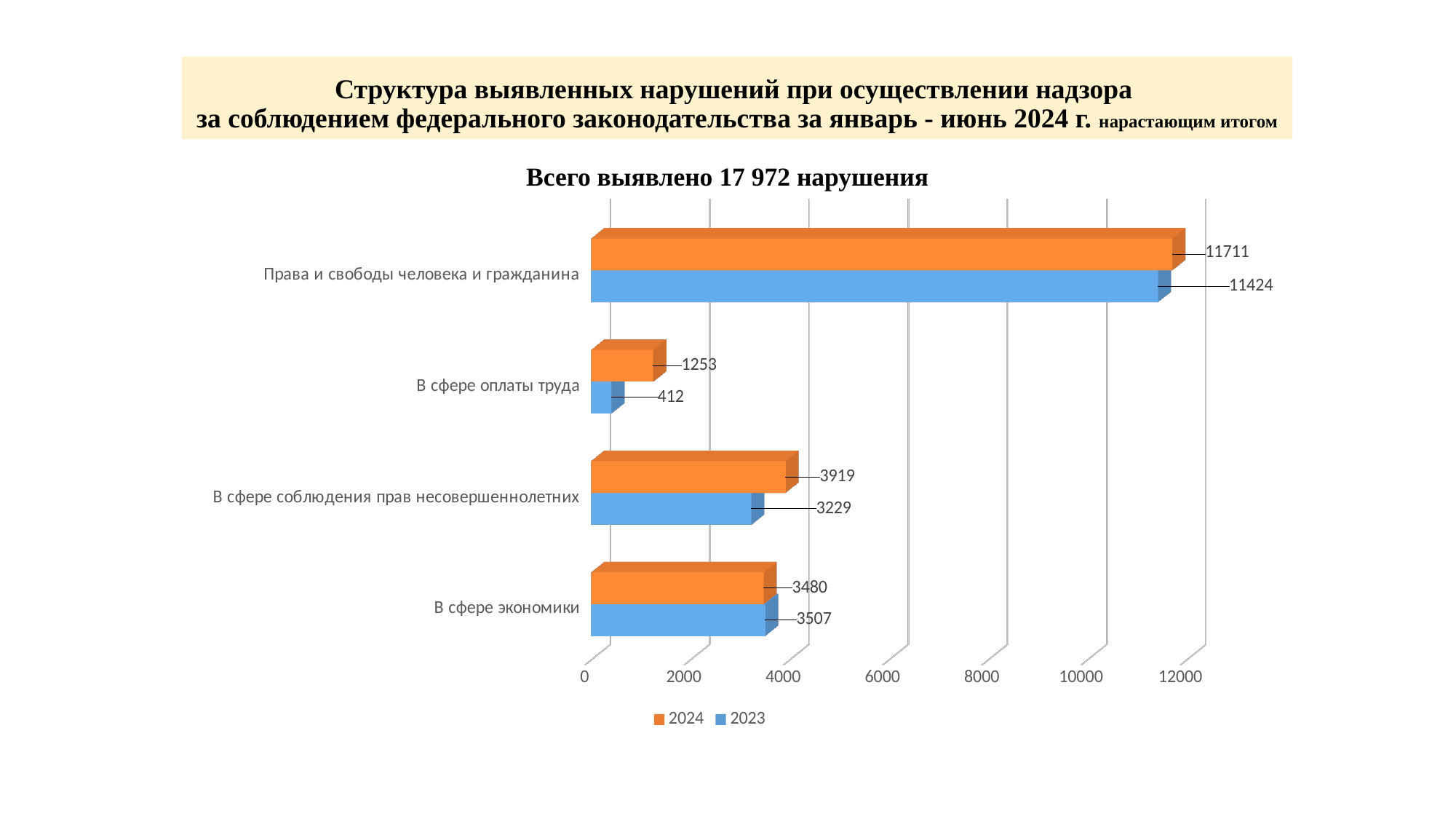
How many series does the legend list? 2 Which colour represents the 2024 series in the legend? Orange What kind of chart is shown on the slide? Bar chart What is the 2024 value for «В сфере соблюдения прав несовершеннолетних»? 3919 Which category has the lowest 2023 value? В сфере оплаты труда What is the difference between the 2024 and 2023 values for «В сфере оплаты труда»? 841 Which category has the highest 2024 value? Права и свободы человека и гражданина How many categories are shown on the chart? 4 What is the 2023 value for «В сфере экономики»? 3507 What is the 2024 value for «Права и свободы человека и гражданина»? 11711 What is the 2023 value for «В сфере оплаты труда»? 412 Which is larger for «В сфере экономики»: the 2024 value or the 2023 value? 2023